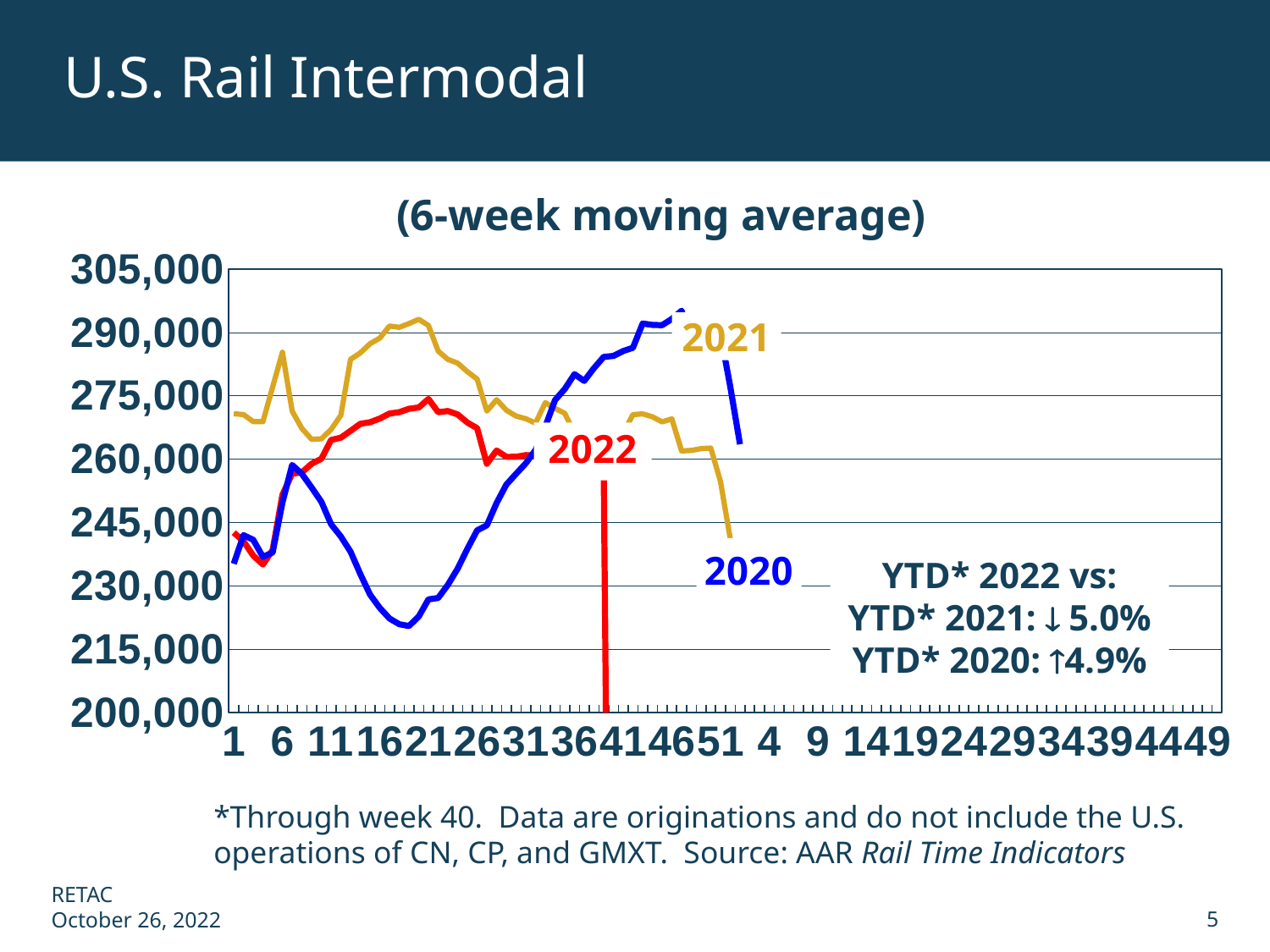
Is the highest point of the 2021 line greater or less than 275,000? greater Is the value of the 2021 line at its final week greater or less than 260,000? less Which series reaches the lowest value on the chart? 2020 What kind of chart is shown on the slide? line chart Which colour is used for the 2022 line? red Is the highest point of the 2022 line greater or less than 290,000? less At week 1, which line is higher, 2020 or 2021? 2021 Does the 2021 line rise or fall over its last several weeks (after about week 40)? fall How many data series (years) are plotted on the chart? 3 According to the annotation, by what percentage is YTD 2022 down versus YTD 2021? 5.0% What is the subtitle shown above the chart? (6-week moving average)